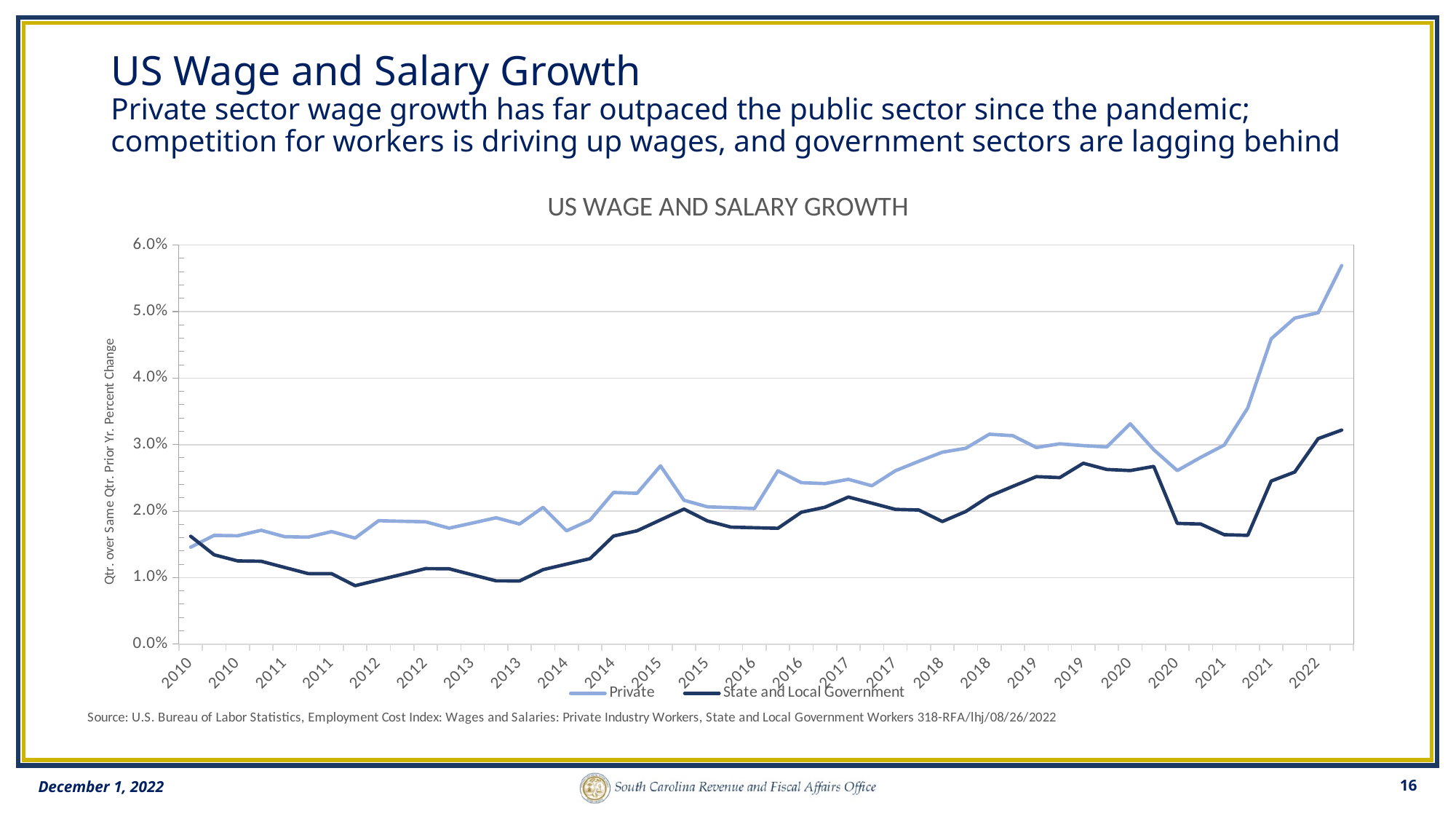
What is the title of the chart? US WAGE AND SALARY GROWTH What kind of chart is shown on the slide? Line chart Which series is lower for most of the period from 2011 to 2019? State and Local Government Does the Private series rise or fall between 2020 and the end of 2022? Rise How many series does the chart's legend list? 2 Is the final 2022 value for the Private series greater or less than 5.0%? greater Is the lowest value of the State and Local Government series greater or less than 2.0%? less Which series reaches the highest value on the chart? Private At the end of 2022, which series is higher, Private or State and Local Government? Private What are the two series named in the chart's legend? Private; State and Local Government Is the 2010 value for the Private series greater or less than 2.0%? less